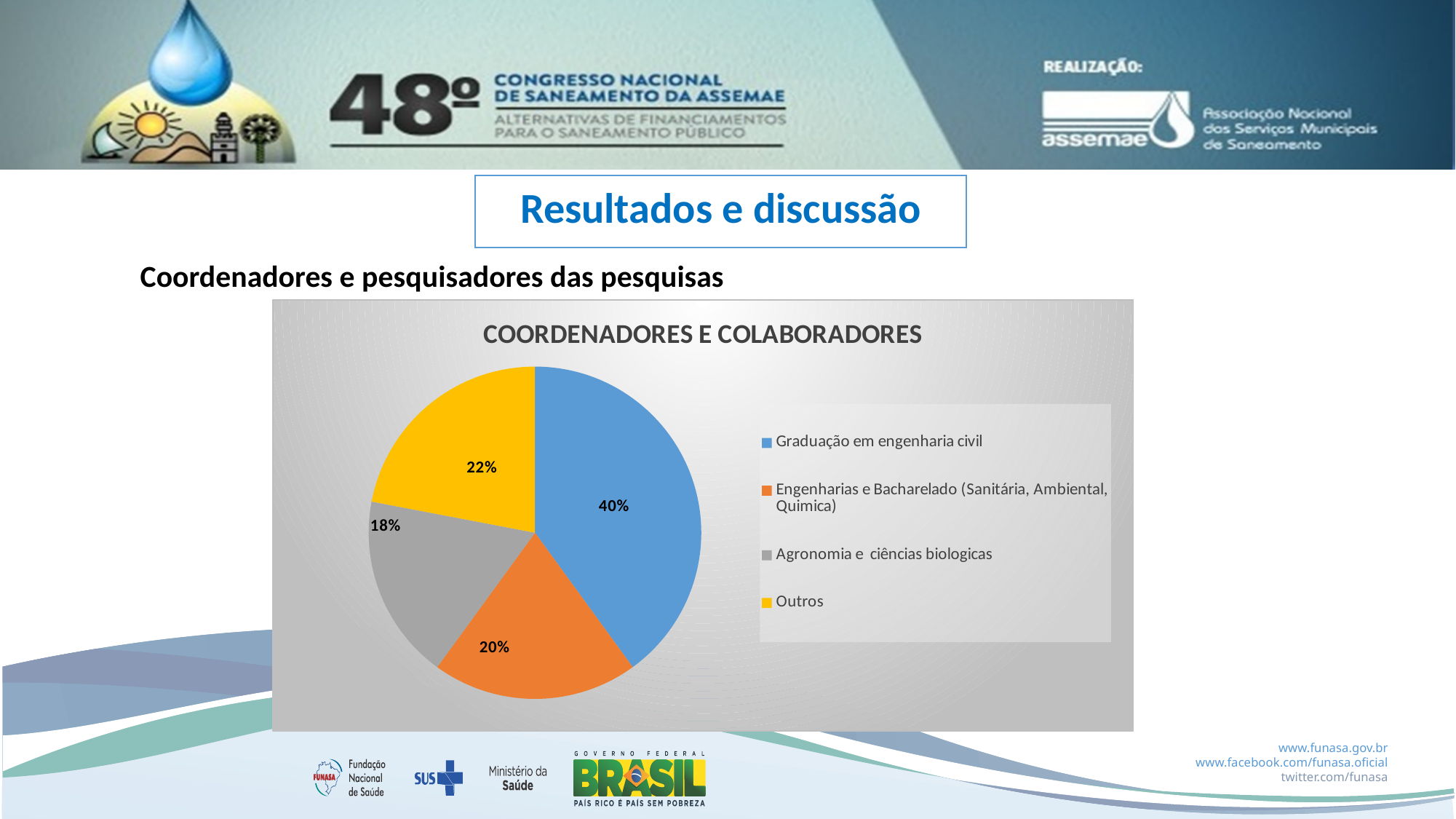
What type of chart is shown on the slide? pie chart What share of the pie does 'Graduação em engenharia civil' represent? 40% What colour is the slice for 'Outros'? yellow What is the difference in percentage points between 'Graduação em engenharia civil' and 'Outros'? 18% Which category has the smallest slice of the pie? Agronomia e ciências biologicas What share of the pie does 'Engenharias e Bacharelado (Sanitária, Ambiental, Quimica)' represent? 20% Which is larger: the slice for 'Outros' or the slice for 'Engenharias e Bacharelado (Sanitária, Ambiental, Quimica)'? Outros What share of the pie does 'Outros' represent? 22% What share of the pie does 'Agronomia e ciências biologicas' represent? 18% Which category has the largest slice of the pie? Graduação em engenharia civil What is the title of the chart? COORDENADORES E COLABORADORES How many categories does the legend list? 4